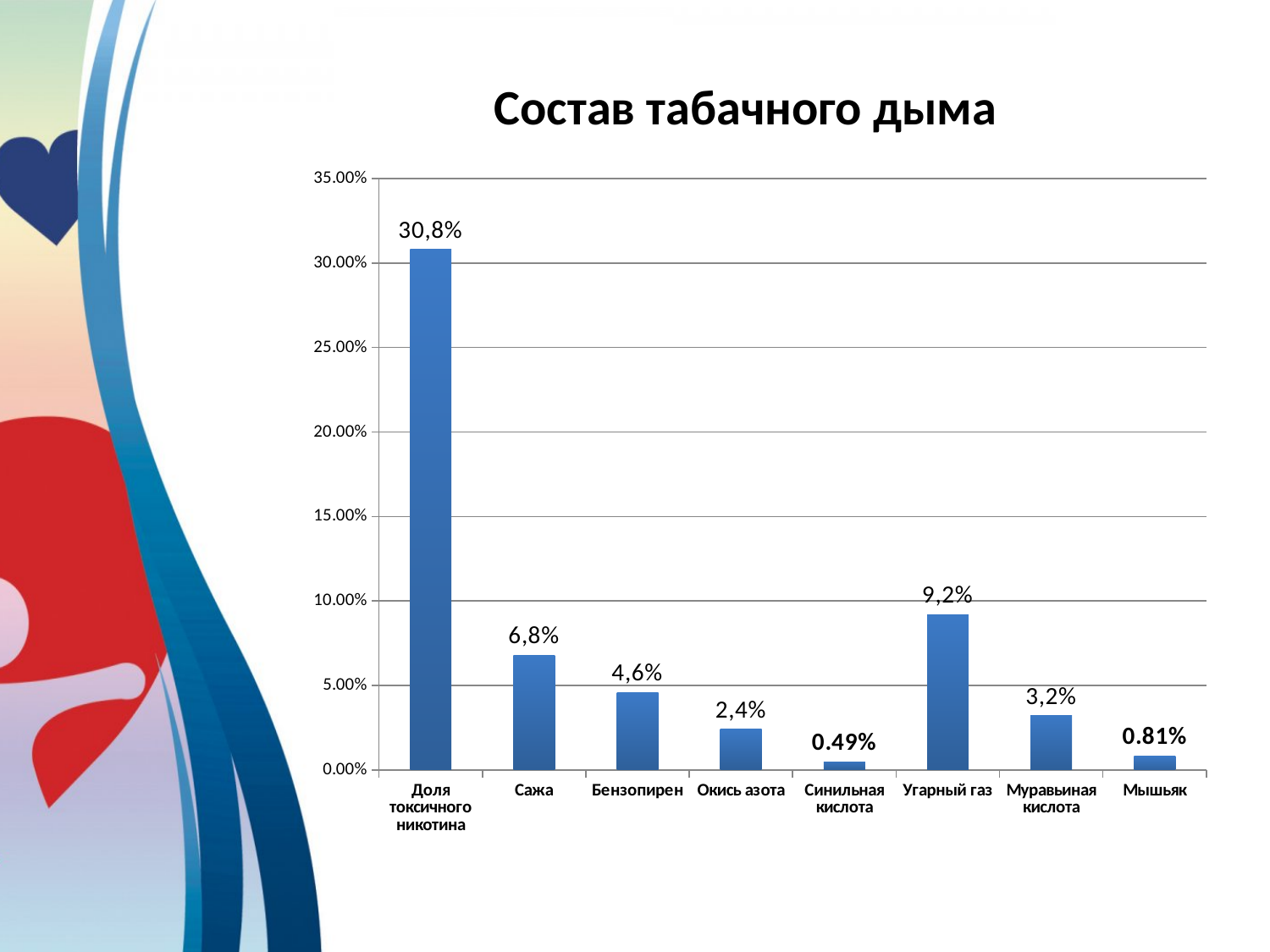
Which category has the highest value? Доля токсичного никотина Which category has the lowest value? Синильная кислота What is the value for Мышьяк? 0.81% What is the title of the chart? Состав табачного дыма What is the difference between the values for Доля токсичного никотина and Угарный газ? 21,6% How many categories are shown on the x axis? 8 What is the difference between the values for Сажа and Бензопирен? 2,2% Which is larger, the value for Окись азота or the value for Муравьиная кислота? Муравьиная кислота What is the value for Угарный газ? 9,2% What is the value for Сажа? 6,8% What is the value for Синильная кислота? 0.49% What kind of chart is shown on the slide? Bar chart